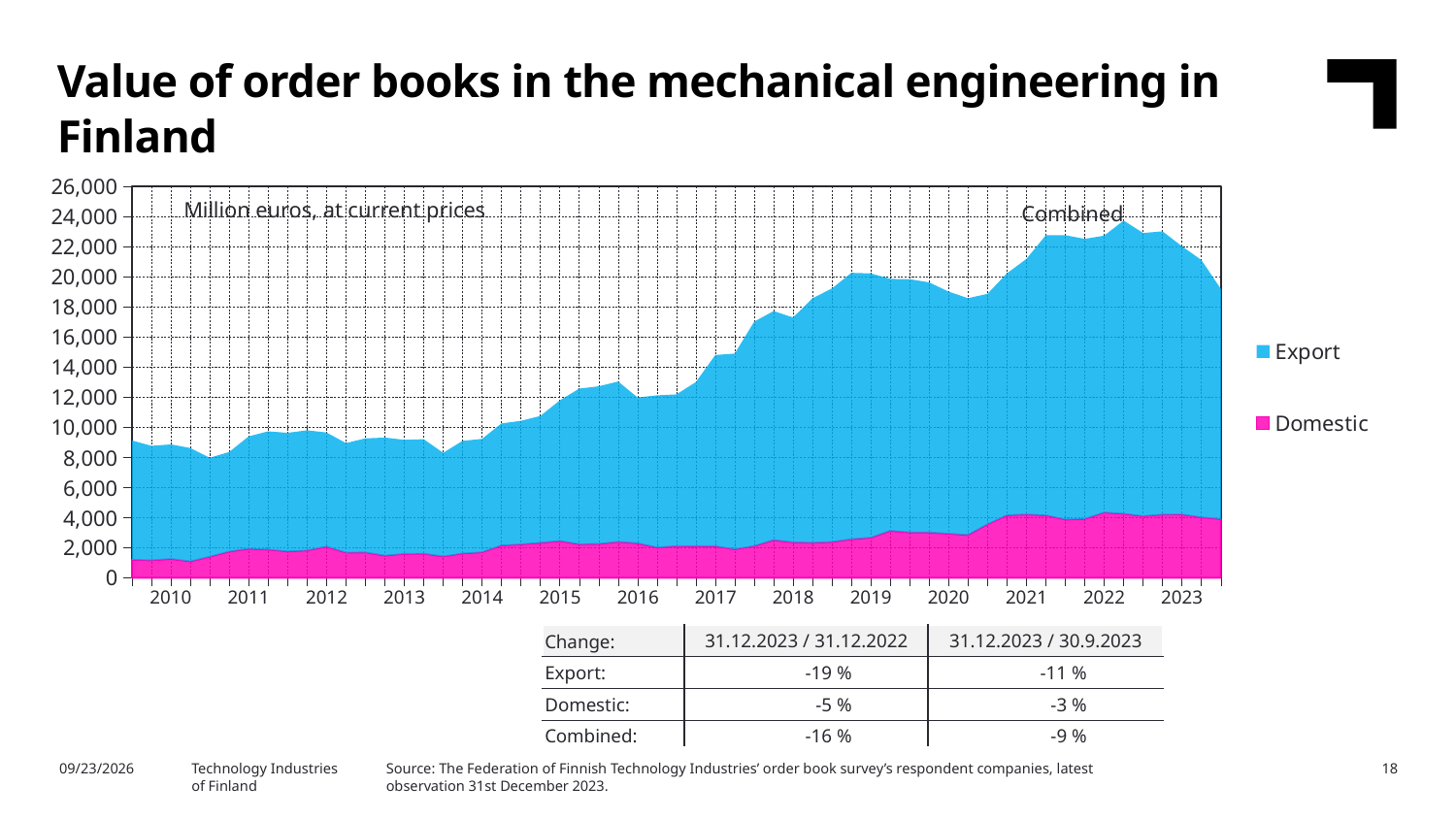
Is the Domestic value at the start of 2010 greater or less than 2,000? less What unit is stated for the values in the chart? Million euros, at current prices Does the combined value of order books generally rise or fall from 2010 to 2022? rise How many series does the legend list? 2 Which series is larger throughout the chart, Export or Domestic? Export What kind of chart is shown on the slide? Stacked area chart Which two series are listed in the chart legend? Export and Domestic Is the combined value at the end of 2023 greater or less than 18,000? greater Is the Domestic value in 2022 greater or less than 3,000? greater How many year labels appear on the x axis of the chart? 14